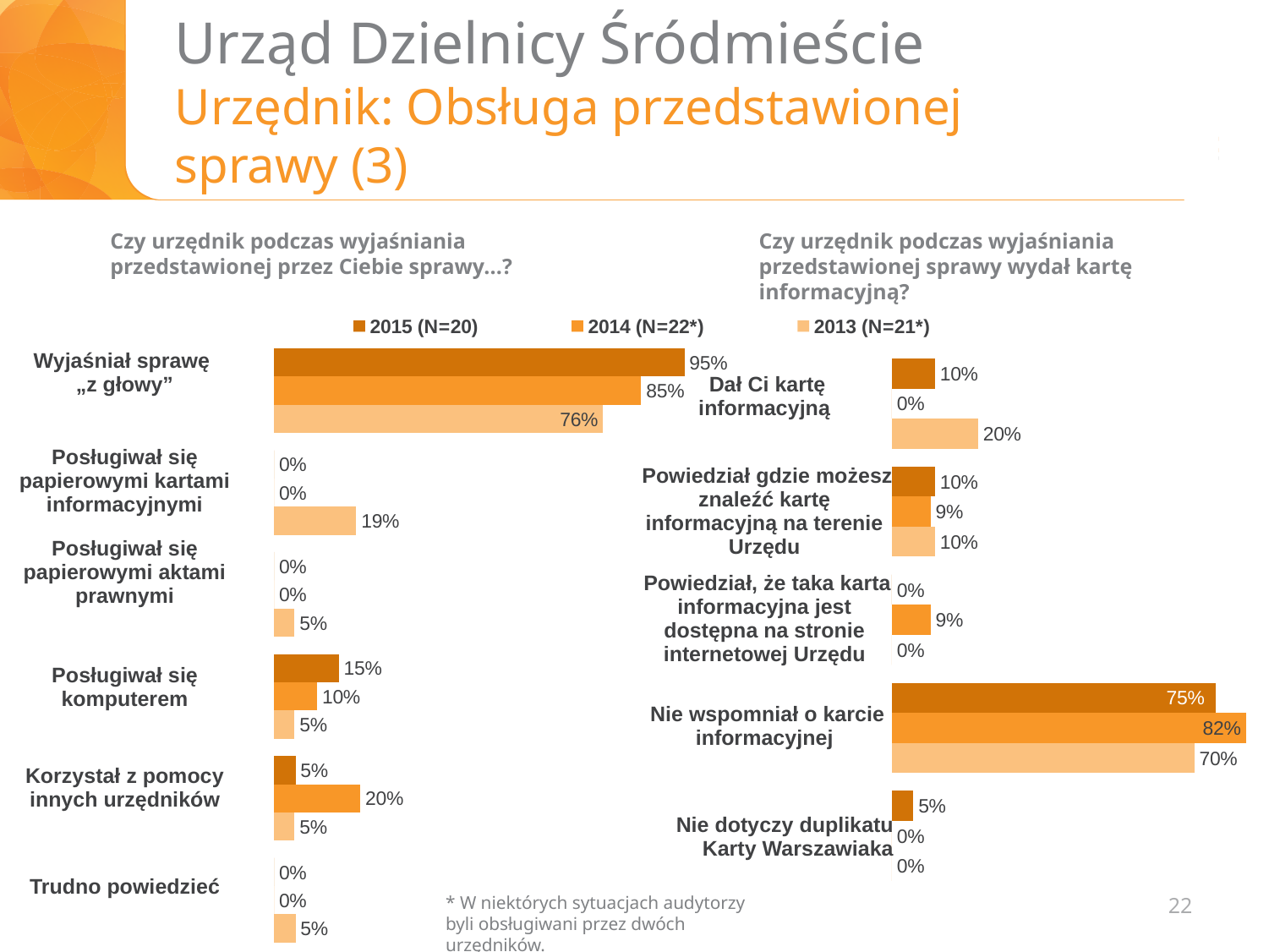
In the left chart, what is the 2014 value for "Korzystał z pomocy innych urzędników"? 20% How many series does the legend list? 3 How many categories does the left chart show? 6 In the right chart ("Czy urzędnik podczas wyjaśniania przedstawionej sprawy wydał kartę informacyjną?"), what is the 2014 value for "Nie wspomniał o karcie informacyjnej"? 82% In the left chart, what is the 2013 value for "Posługiwał się papierowymi kartami informacyjnymi"? 19% In the left chart, what is the difference between the 2015 and 2013 values for "Wyjaśniał sprawę „z głowy”"? 19 percentage points In the right chart, is the 2015 value for "Nie wspomniał o karcie informacyjnej" larger or smaller than the 2013 value? larger In the right chart, which category has the highest 2015 value? Nie wspomniał o karcie informacyjnej What type of chart is used on this slide? Bar chart In the left chart ("Czy urzędnik podczas wyjaśniania przedstawionej przez Ciebie sprawy...?"), what is the 2015 value for "Wyjaśniał sprawę „z głowy”"? 95% In the right chart, what is the 2013 value for "Dał Ci kartę informacyjną"? 20% In the left chart, which year has the highest value for "Posługiwał się komputerem"? 2015